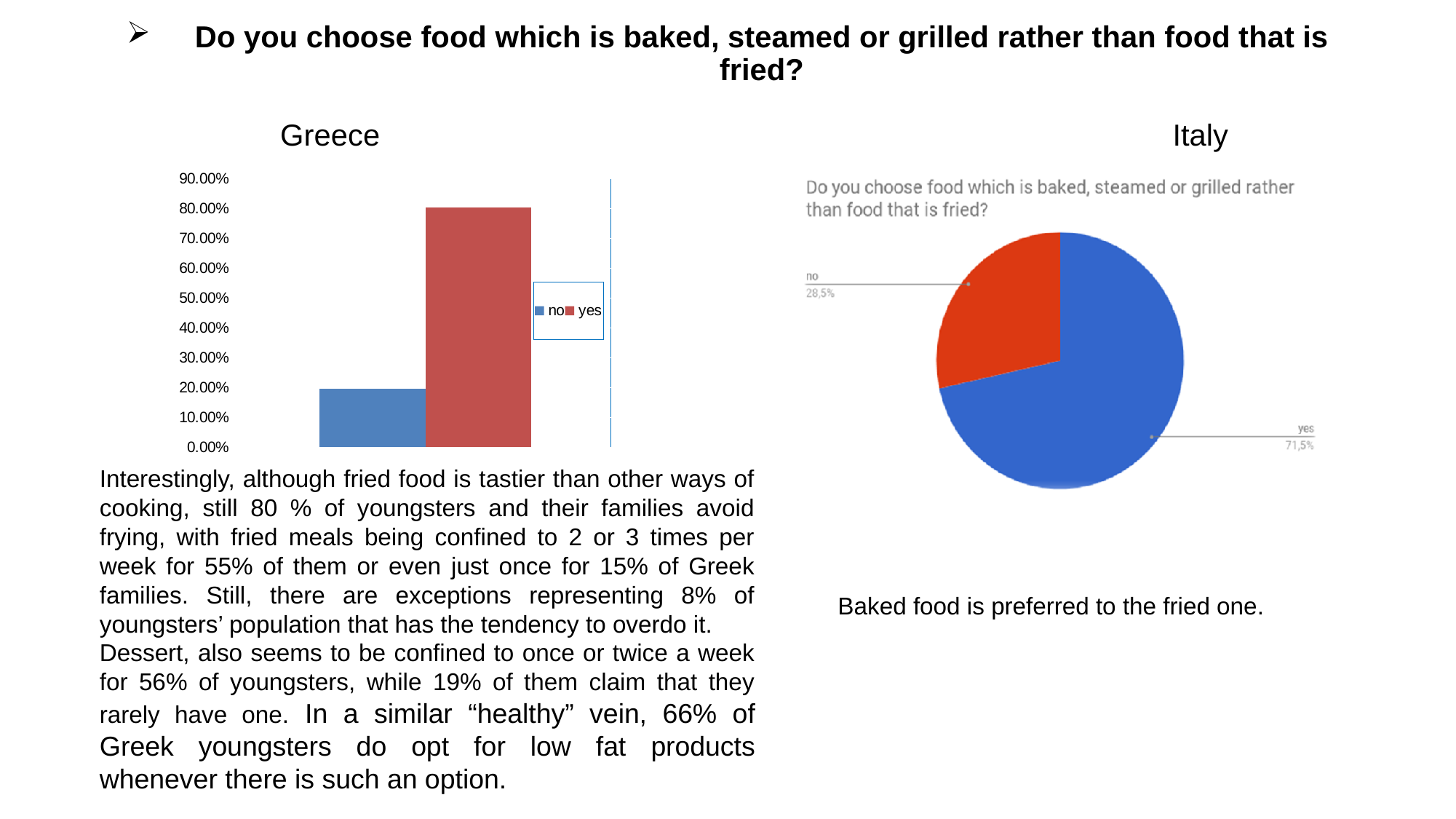
In the Greece chart, is the value for yes greater or less than 70.00%? greater In the Greece chart, which answer has the higher value, yes or no? yes What kind of chart is the Italy chart? pie chart How many series does the legend of the Greece chart list? 2 In the Greece chart, is the value for no greater or less than 30.00%? less In the Italy pie chart, what colour is the yes slice? blue In the Italy pie chart, which slice is the largest? yes In the Italy pie chart, what share of respondents answered no? 28,5% In the Italy pie chart, what share of respondents answered yes? 71,5% What kind of chart is the Greece chart? bar chart